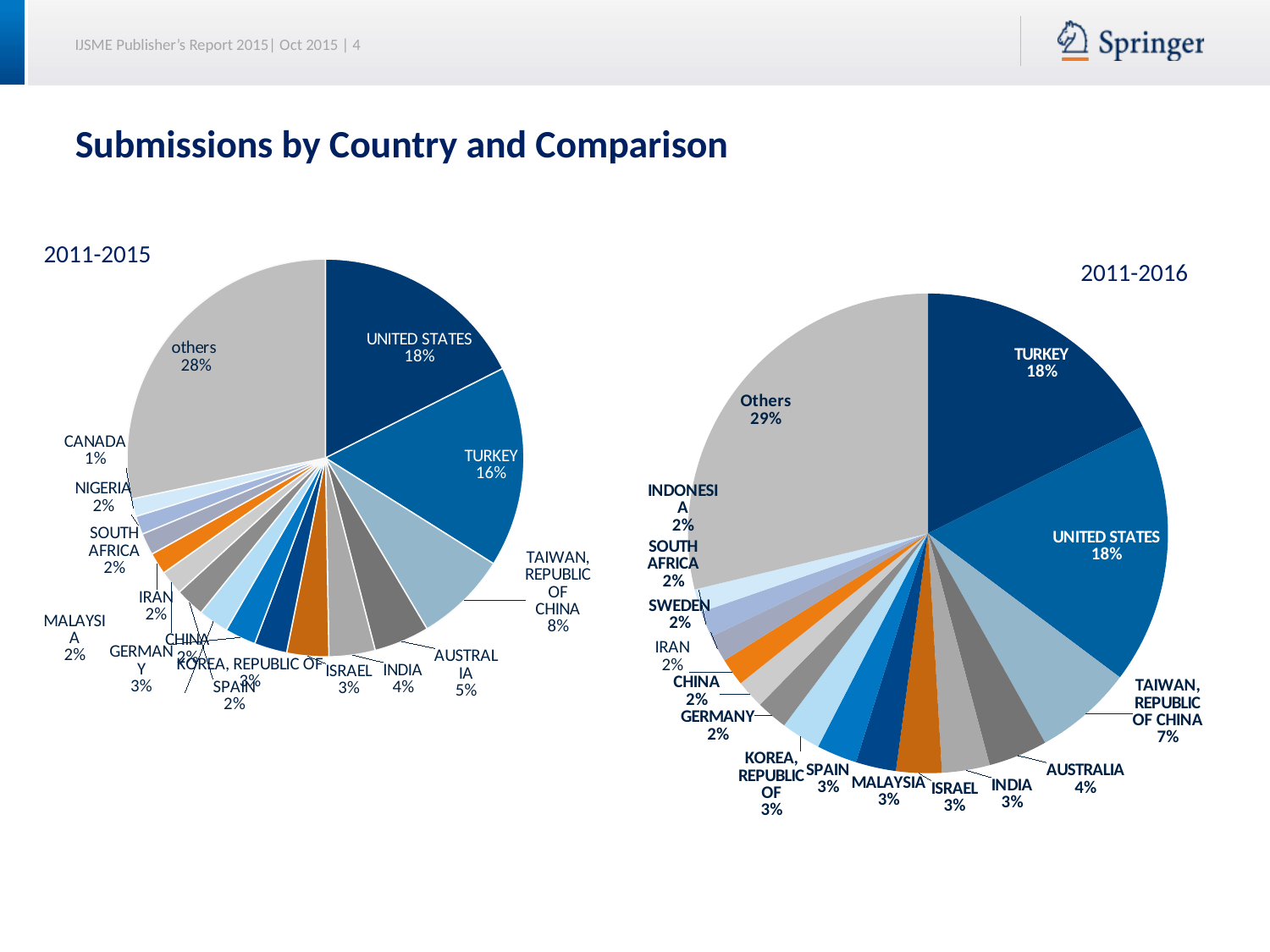
In the 2011-2016 pie chart, what is the share for Australia? 4% What is the title of the slide? Submissions by Country and Comparison In the 2011-2016 pie chart, what is the share of the 'Others' slice? 29% What kind of chart is the 2011-2015 chart on the left? Pie chart In the 2011-2015 pie chart, which country has the smallest share? CANADA In the 2011-2016 pie chart, which is larger, the share for India or the share for Australia? Australia In the 2011-2015 pie chart, what share of submissions came from Turkey? 16% In the 2011-2016 pie chart, what share of submissions came from Turkey? 18% How many slices does the 2011-2016 pie chart have? 16 In the 2011-2015 pie chart, what is the share for Taiwan, Republic of China? 8% In the 2011-2015 pie chart, what is the difference between the United States share and the Turkey share? 2% In the 2011-2015 pie chart, which named country (excluding 'others') has the largest share? UNITED STATES